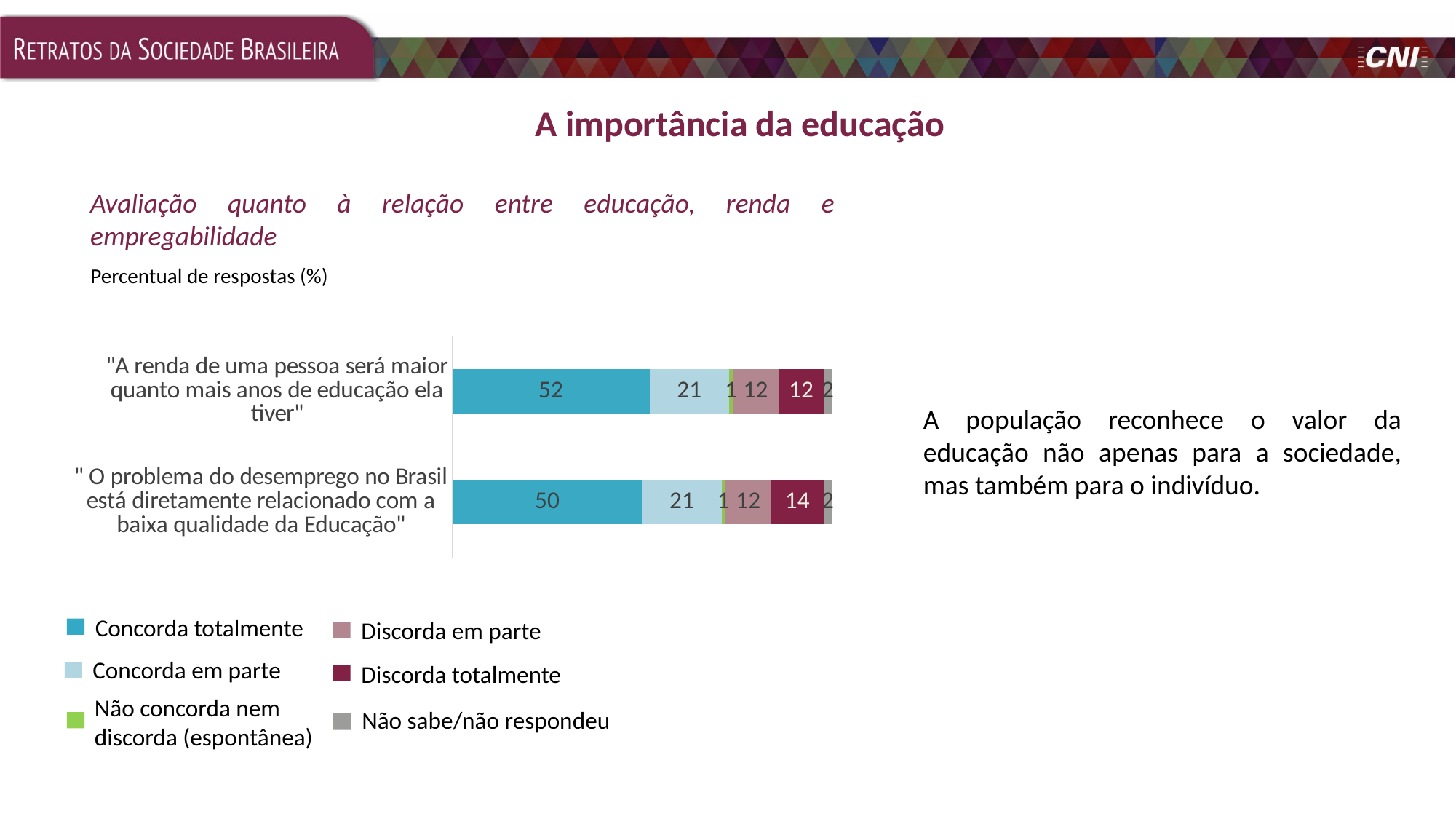
How many statements (categories) does the chart show? 2 What kind of chart is shown on the slide? Stacked bar chart What is the 'Discorda totalmente' value for the statement about unemployment being related to low quality of education? 14 Which statement has the higher 'Concorda totalmente' value? "A renda de uma pessoa será maior quanto mais anos de educação ela tiver" What is the 'Concorda em parte' value for the statement about unemployment and the quality of education? 21 Which response category has the smallest value for the statement about income and years of education? Não concorda nem discorda (espontânea) What is the 'Discorda totalmente' value for the statement about income being higher with more years of education? 12 What is the 'Não sabe/não respondeu' value for the statement about unemployment and the quality of education? 2 How many series does the legend list? 6 What percentage of respondents 'Concorda totalmente' with the statement "O problema do desemprego no Brasil está diretamente relacionado com a baixa qualidade da Educação"? 50 What is the difference between the 'Concorda totalmente' values of the two statements? 2 What percentage of respondents 'Concorda totalmente' with the statement "A renda de uma pessoa será maior quanto mais anos de educação ela tiver"? 52